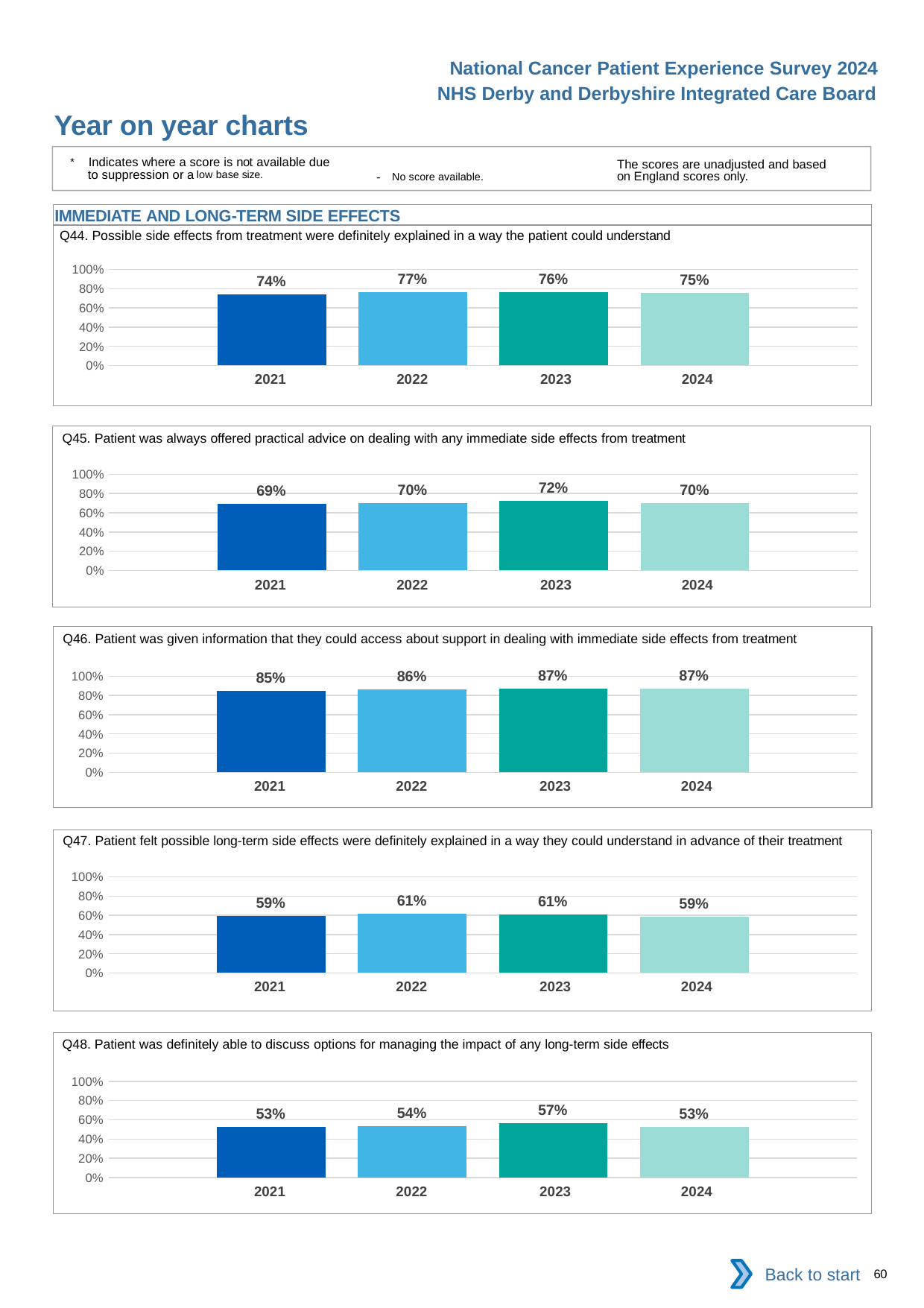
In the Q48 chart, which year has the highest value? 2023 In the Q47 chart, which is larger, the value for 2022 or the value for 2024? 2022 How many years are shown in the Q48 chart? 4 In the Q46 chart, is the value for 2024 greater or less than 80%? greater In the Q46 chart, what is the value for 2021? 85% In the Q44 chart, which year has the lowest value? 2021 In the Q45 chart, what is the difference between the 2023 and 2021 values? 3 percentage points In the Q45 chart, which year has the highest value? 2023 In the Q47 chart, what is the value for 2024? 59% What kind of chart is the Q44 chart? Bar chart In the Q48 chart, what is the difference between the 2023 and 2024 values? 4 percentage points In the Q44 chart, what is the value for 2022? 77%